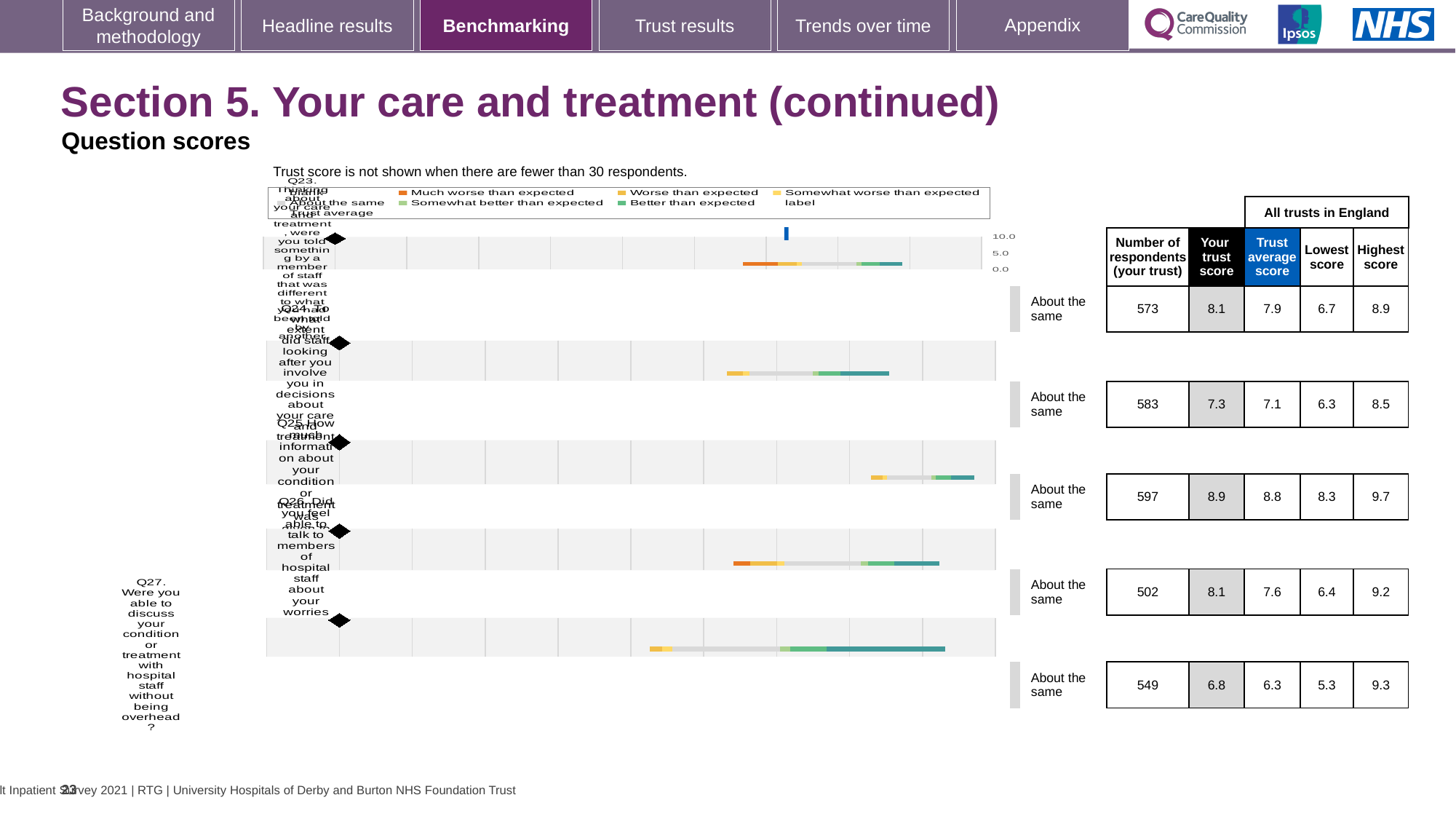
What colour represents 'Much worse than expected' in the chart legend? orange How many questions (Q23 to Q27) are plotted in the chart? 5 What is the 'Trust average score' for Q24 (staff involving you in decisions about your care and treatment)? 7.1 What benchmark category is shown for Q26 (able to talk to hospital staff about your worries)? About the same Which question has the lowest 'Your trust score'? Q27 What kind of chart is used to show the question scores on this slide? bar chart What is the 'Highest score' across all trusts in England for Q25? 9.7 Which question has the highest 'Your trust score'? Q25 How many respondents answered Q27 (discussing your condition without being overheard)? 549 What is the 'Your trust score' for Q23 (being told something different by another member of staff)? 8.1 What is the difference between the 'Your trust score' for Q25 and for Q27? 2.1 Which is larger, the 'Your trust score' for Q24 or for Q26? Q26